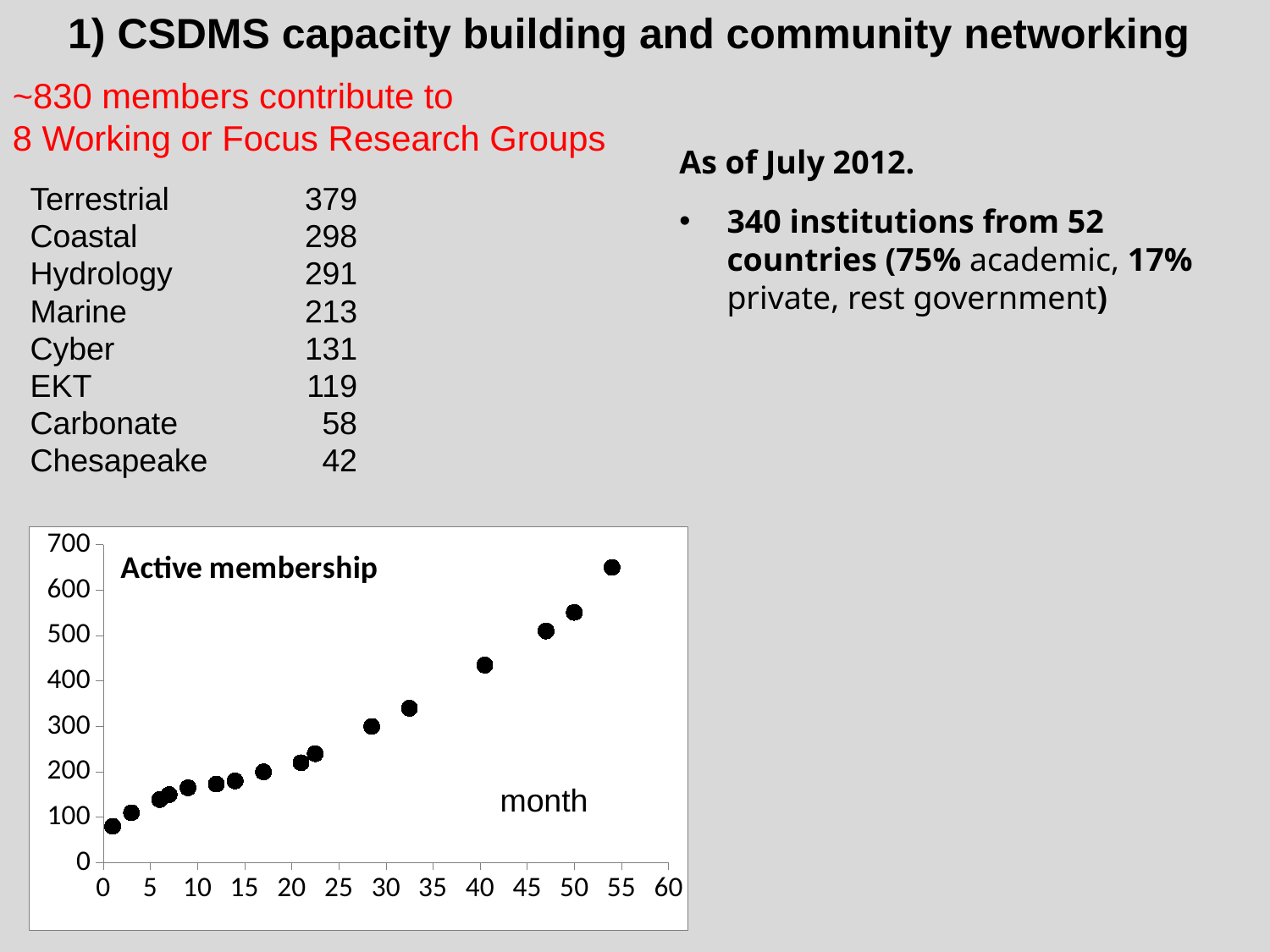
Is the active membership value at the first plotted point (around month 1) greater or less than 100? less Is the active membership value at around month 17 greater or less than 300? less What is the highest value shown on the y axis of the chart? 700 What kind of chart is shown on the slide? scatter chart Which is larger, the active membership at around month 54 or at around month 47? month 54 Is the active membership value at around month 50 greater or less than 500? greater Do the active membership values rise or fall as the month increases? rise What label is shown for the x axis of the chart? month What is the title of the chart? Active membership